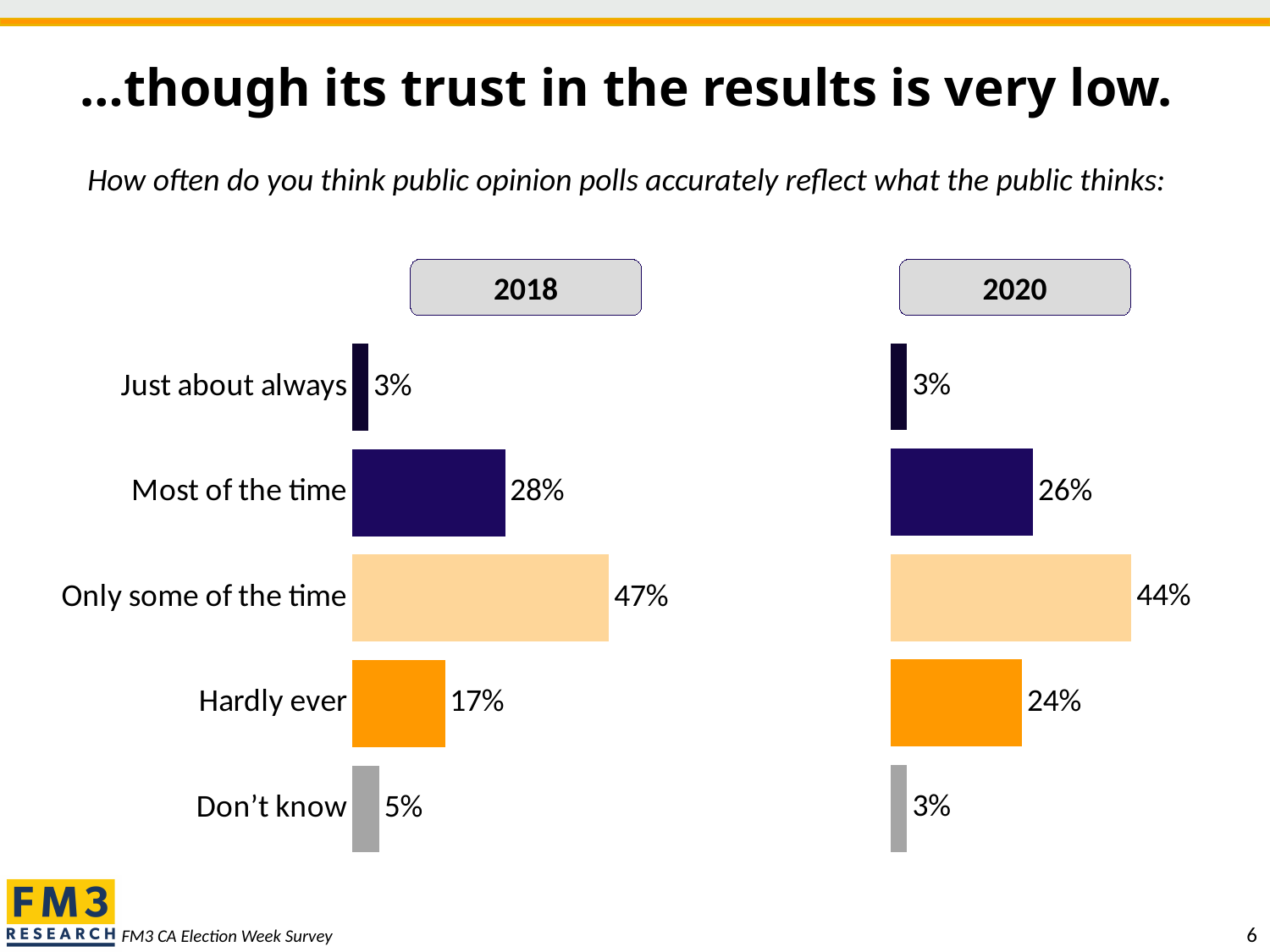
Is the "Most of the time" percentage larger in the 2018 chart or the 2020 chart? 2018 In the 2020 chart, which response has the highest percentage? Only some of the time What type of chart is used for the 2020 results? Bar chart In the 2018 chart, which response has the lowest percentage? Just about always In the 2018 chart, what percentage said "Only some of the time"? 47% In the 2018 chart, what is the difference between "Only some of the time" and "Most of the time"? 19% What is the difference between the "Hardly ever" percentages in the 2020 chart and the 2018 chart? 7% In the 2020 chart, what percentage said "Hardly ever"? 24% In the 2020 chart, what percentage said "Most of the time"? 26% In the 2018 chart, what percentage said "Don't know"? 5% In the 2018 chart, which response has the highest percentage? Only some of the time How many response categories are shown in the 2018 chart? 5